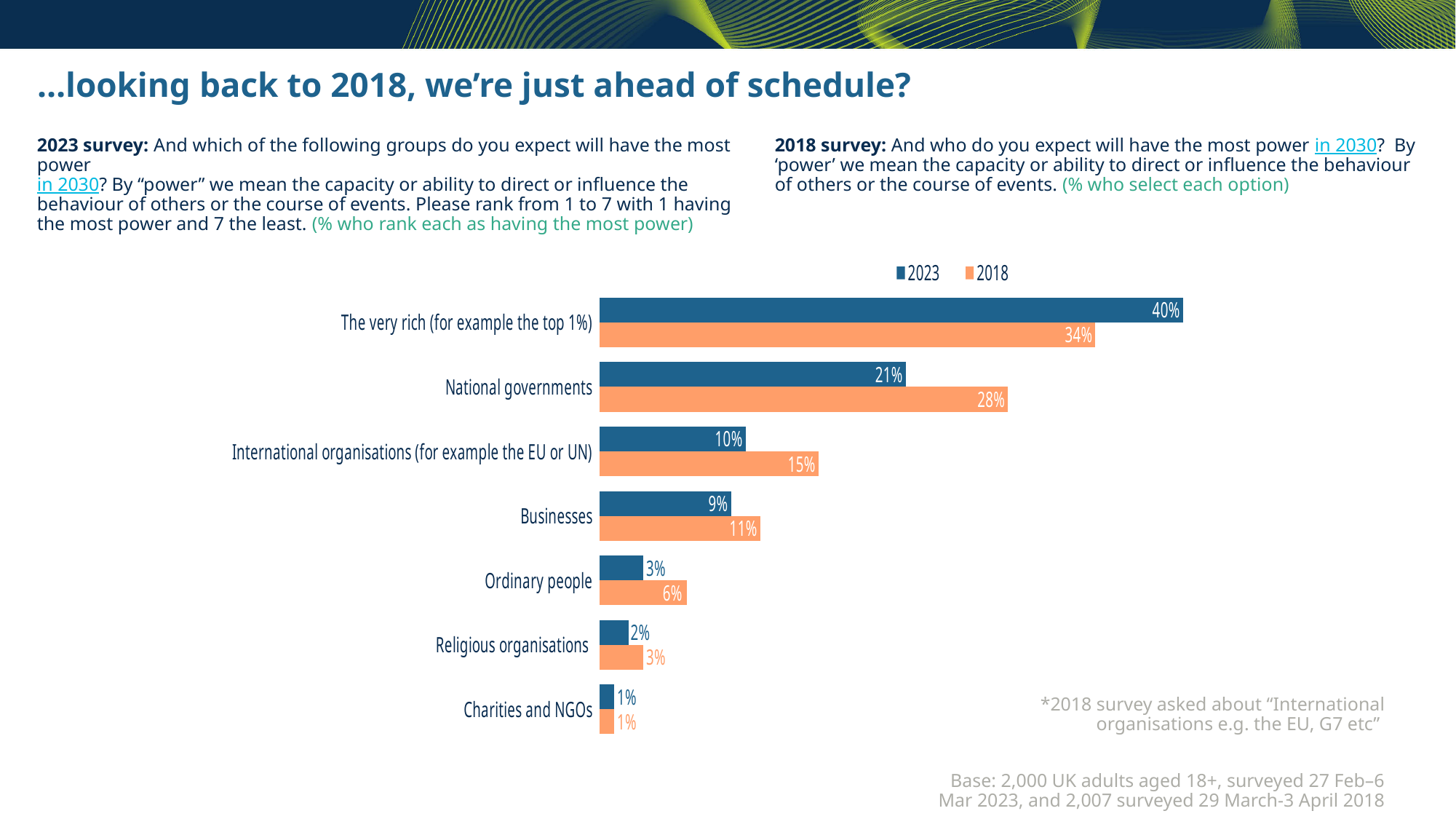
What was the 2018 value for National governments? 28% What is the 2023 value for International organisations (for example the EU or UN)? 10% What is the difference between the 2023 and 2018 values for the very rich (for example the top 1%)? 6 percentage points Which group has the highest value in the 2023 series? The very rich (for example the top 1%) Which is larger for Businesses: the 2023 value or the 2018 value? 2018 By how many percentage points did the value for National governments fall from 2018 to 2023? 7 percentage points How many series does the legend list? 2 Which colour represents the 2018 series in the chart? Orange How many groups are shown on the chart? 7 What kind of chart is shown on the slide? Bar chart What percentage of respondents in the 2023 survey expect the very rich (for example the top 1%) to have the most power in 2030? 40% Which group has the lowest value in the 2018 series? Charities and NGOs